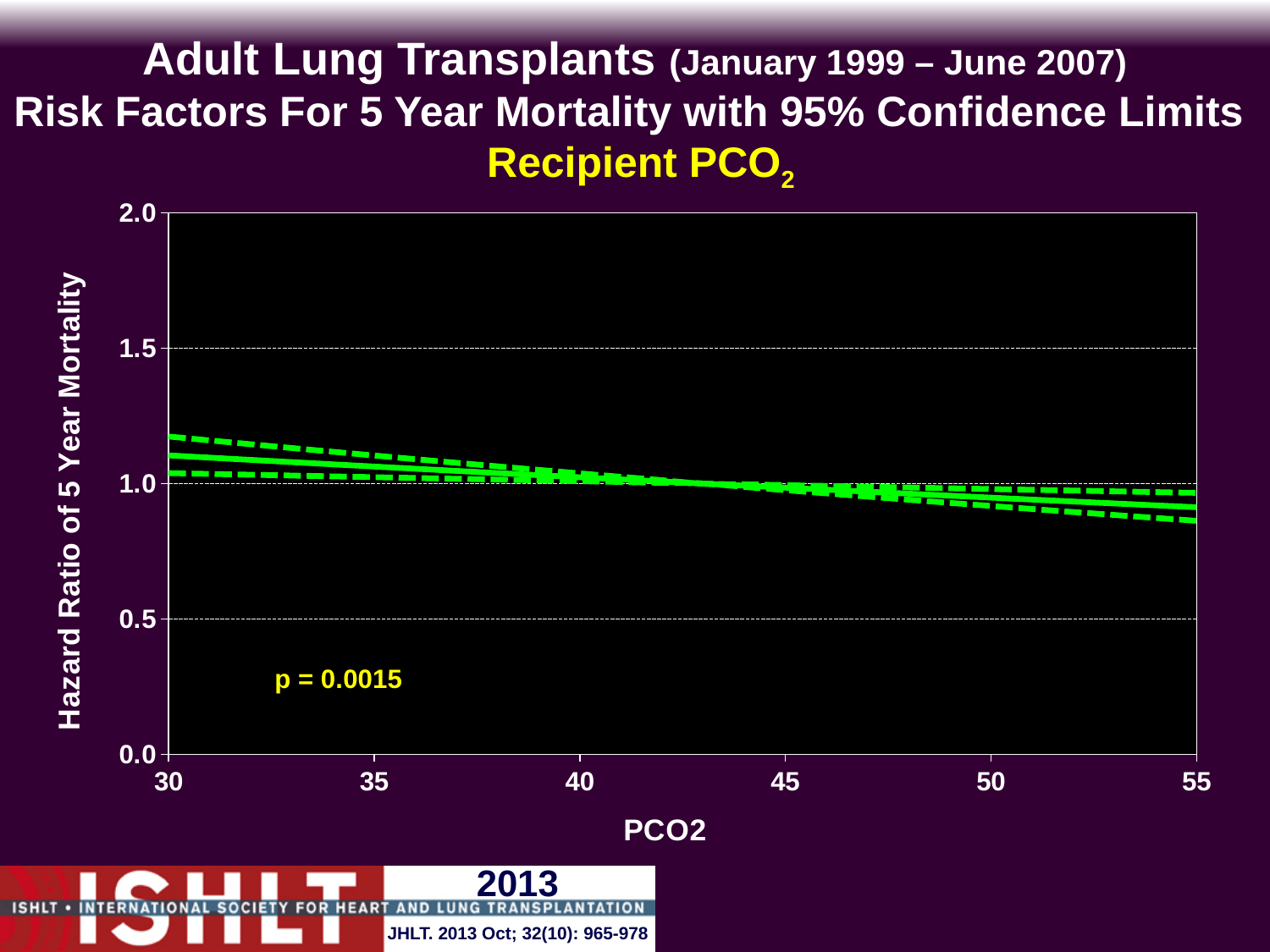
What kind of chart is shown on the slide? line chart Is the hazard ratio at a PCO2 of 30 greater or less than 1.0? greater Does the hazard ratio rise or fall as PCO2 increases from 30 to 55? fall How many tick labels are shown on the PCO2 axis? 6 Is the hazard ratio at a PCO2 of 30 greater or less than 1.5? less What p-value is printed on the chart? p = 0.0015 Is the hazard ratio higher at a PCO2 of 30 or at a PCO2 of 55? 30 Is the hazard ratio at a PCO2 of 55 greater or less than 0.5? greater What is the label of the vertical axis? Hazard Ratio of 5 Year Mortality